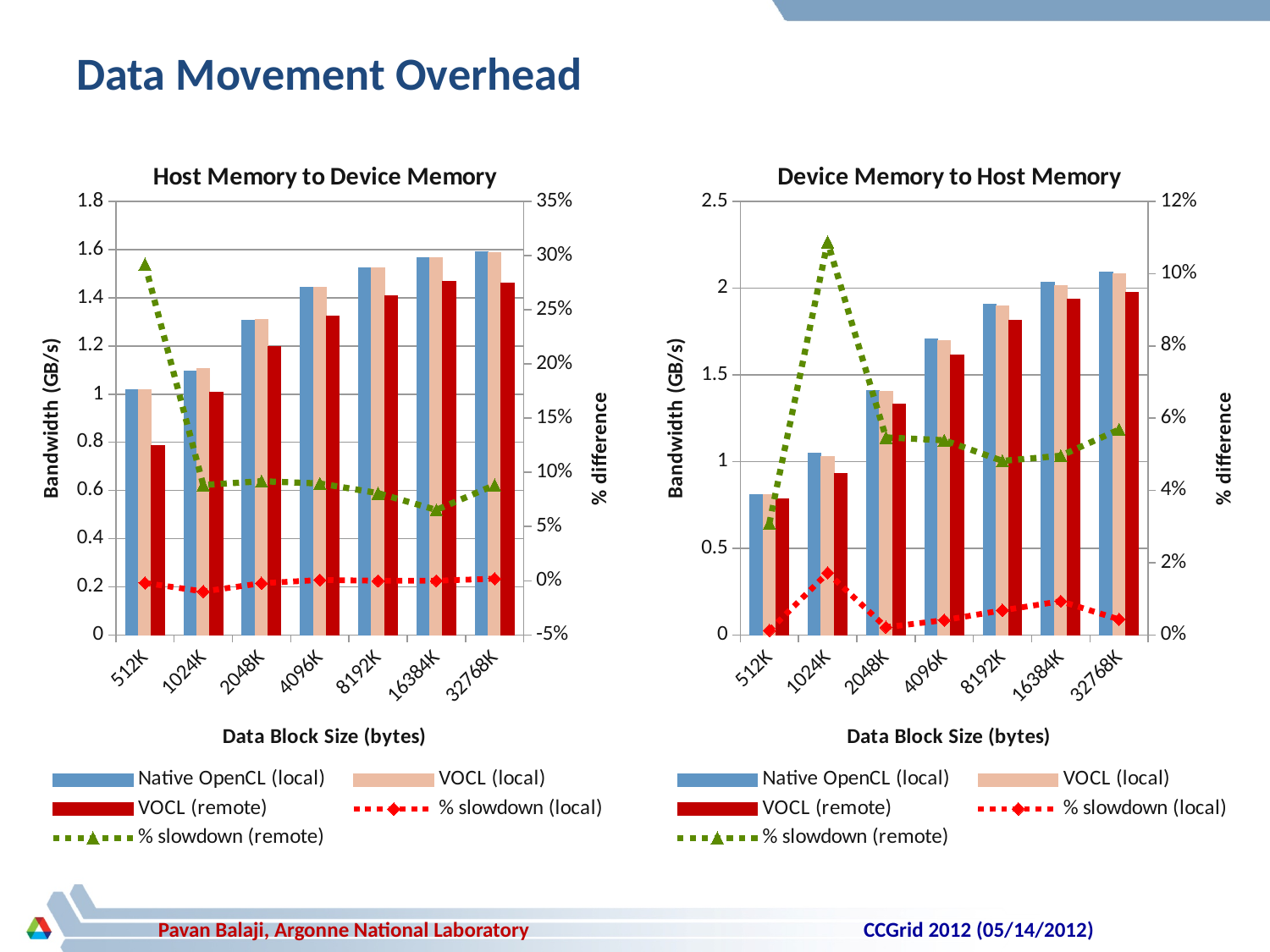
In the 'Device Memory to Host Memory' chart, at which data block size is the % slowdown (remote) highest? 1024K What is the label of the left vertical axis in the 'Device Memory to Host Memory' chart? Bandwidth (GB/s) In the 'Host Memory to Device Memory' chart, at which data block size is the VOCL (remote) bandwidth lowest? 512K In the 'Device Memory to Host Memory' chart, is the Native OpenCL (local) bandwidth at 32768K greater or less than 2? greater In the 'Host Memory to Device Memory' chart, what kind of chart is used to show the bandwidth series? bar chart In the 'Device Memory to Host Memory' chart, does the Native OpenCL (local) bandwidth rise or fall as the data block size increases? rise In the 'Device Memory to Host Memory' chart, how many series does the legend list? 5 In the 'Device Memory to Host Memory' chart, at 2048K, which is larger: the Native OpenCL (local) bandwidth or the VOCL (remote) bandwidth? Native OpenCL (local) In the 'Host Memory to Device Memory' chart, at which data block size is the % slowdown (remote) highest? 512K In the 'Host Memory to Device Memory' chart, is the VOCL (remote) bandwidth at 512K greater or less than 1? less In the 'Host Memory to Device Memory' chart, how many data block sizes are shown on the x axis? 7 In the 'Host Memory to Device Memory' chart, is the % slowdown (remote) at 512K greater or less than 25%? greater